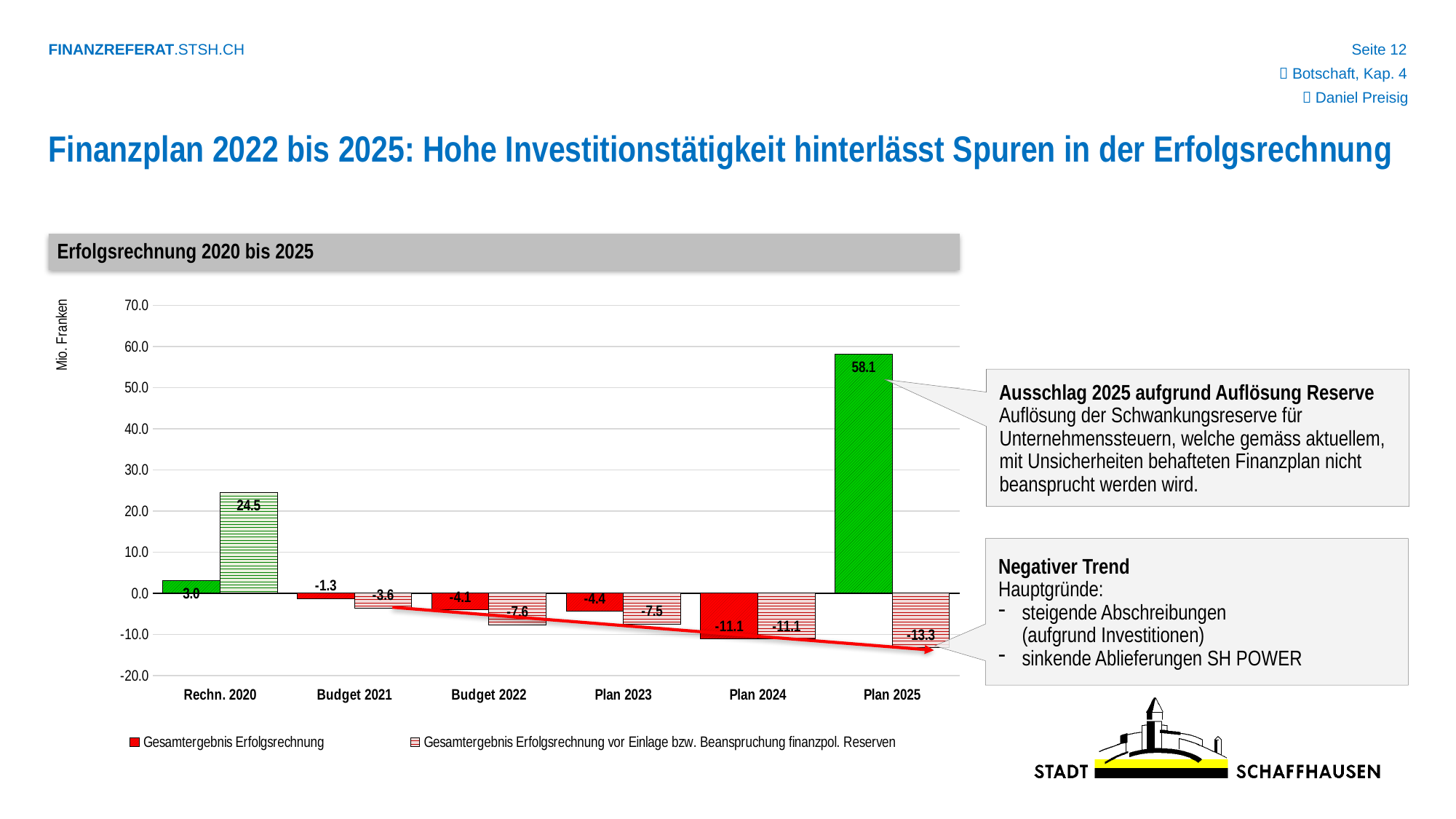
How many series does the chart legend list? 2 What unit is shown on the y axis of the chart? Mio. Franken Which is larger: the 'Gesamtergebnis Erfolgsrechnung' value for Budget 2022 or for Plan 2024? Budget 2022 What type of chart is shown under the heading 'Erfolgsrechnung 2020 bis 2025'? Bar chart What is the value of 'Gesamtergebnis Erfolgsrechnung vor Einlage bzw. Beanspruchung finanzpol. Reserven' for Rechn. 2020? 24.5 What is the value of 'Gesamtergebnis Erfolgsrechnung' for Plan 2024? -11.1 What is the value of 'Gesamtergebnis Erfolgsrechnung' for Plan 2025? 58.1 What is the difference between the 'Gesamtergebnis Erfolgsrechnung' value for Plan 2025 and for Rechn. 2020? 55.1 What is the value of 'Gesamtergebnis Erfolgsrechnung vor Einlage bzw. Beanspruchung finanzpol. Reserven' for Plan 2025? -13.3 Which category has the highest value for 'Gesamtergebnis Erfolgsrechnung'? Plan 2025 How many categories are shown on the x axis of the chart? 6 Which category has the lowest value for 'Gesamtergebnis Erfolgsrechnung vor Einlage bzw. Beanspruchung finanzpol. Reserven'? Plan 2025